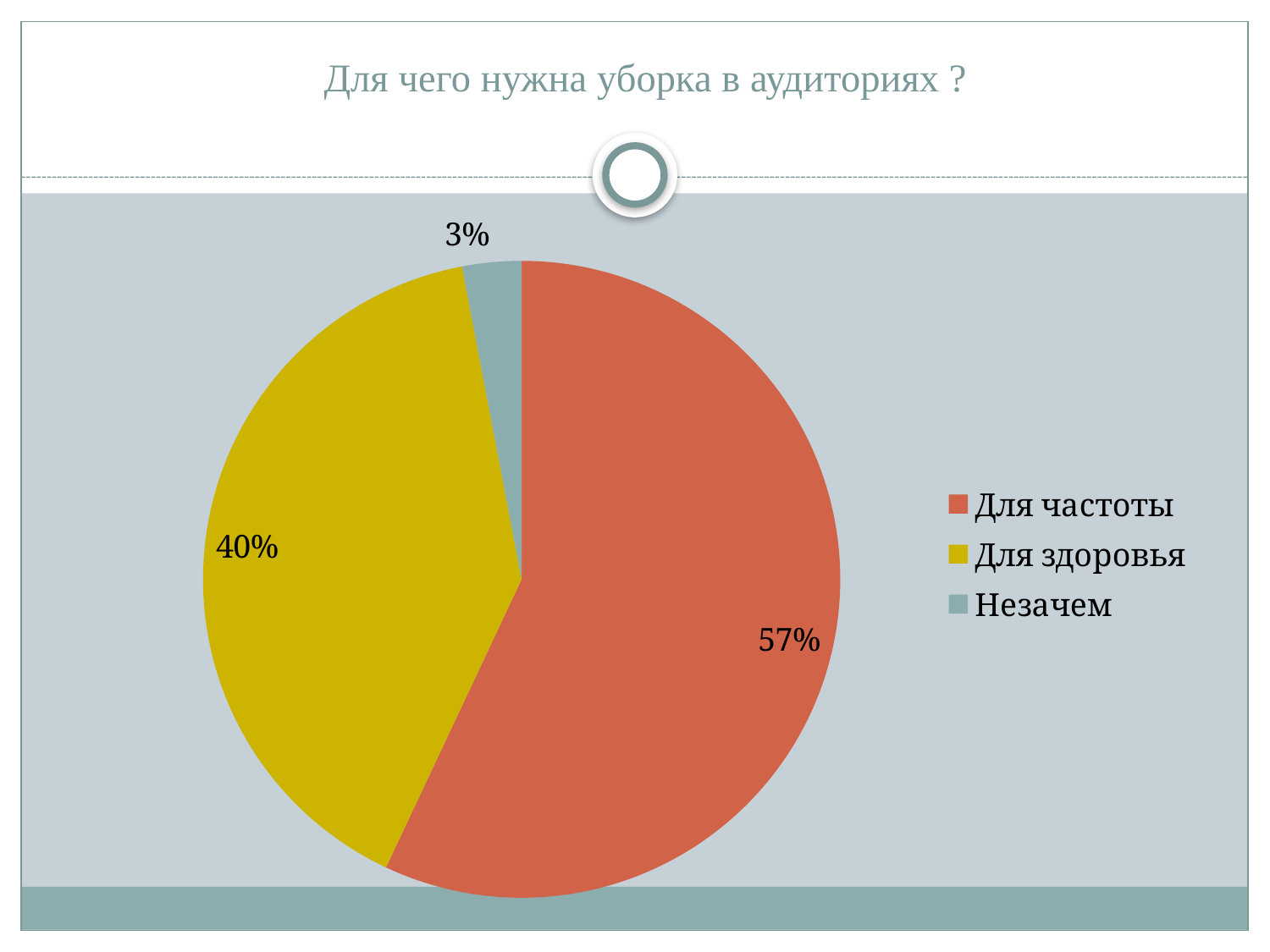
What colour is the slice for "Для здоровья"? yellow What share of the pie does "Для частоты" have? 57% How many categories does the pie chart show? 3 What kind of chart is shown on the slide? pie chart What share of the pie does "Для здоровья" have? 40% Which category has the smallest slice of the pie? Незачем What is the difference in percentage points between "Для здоровья" and "Незачем"? 37 What is the title of the slide? Для чего нужна уборка в аудиториях ? What is the difference in percentage points between "Для частоты" and "Для здоровья"? 17 What share of the pie does "Незачем" have? 3% Which is larger, the share for "Для здоровья" or the share for "Незачем"? Для здоровья Which category has the largest slice of the pie? Для частоты